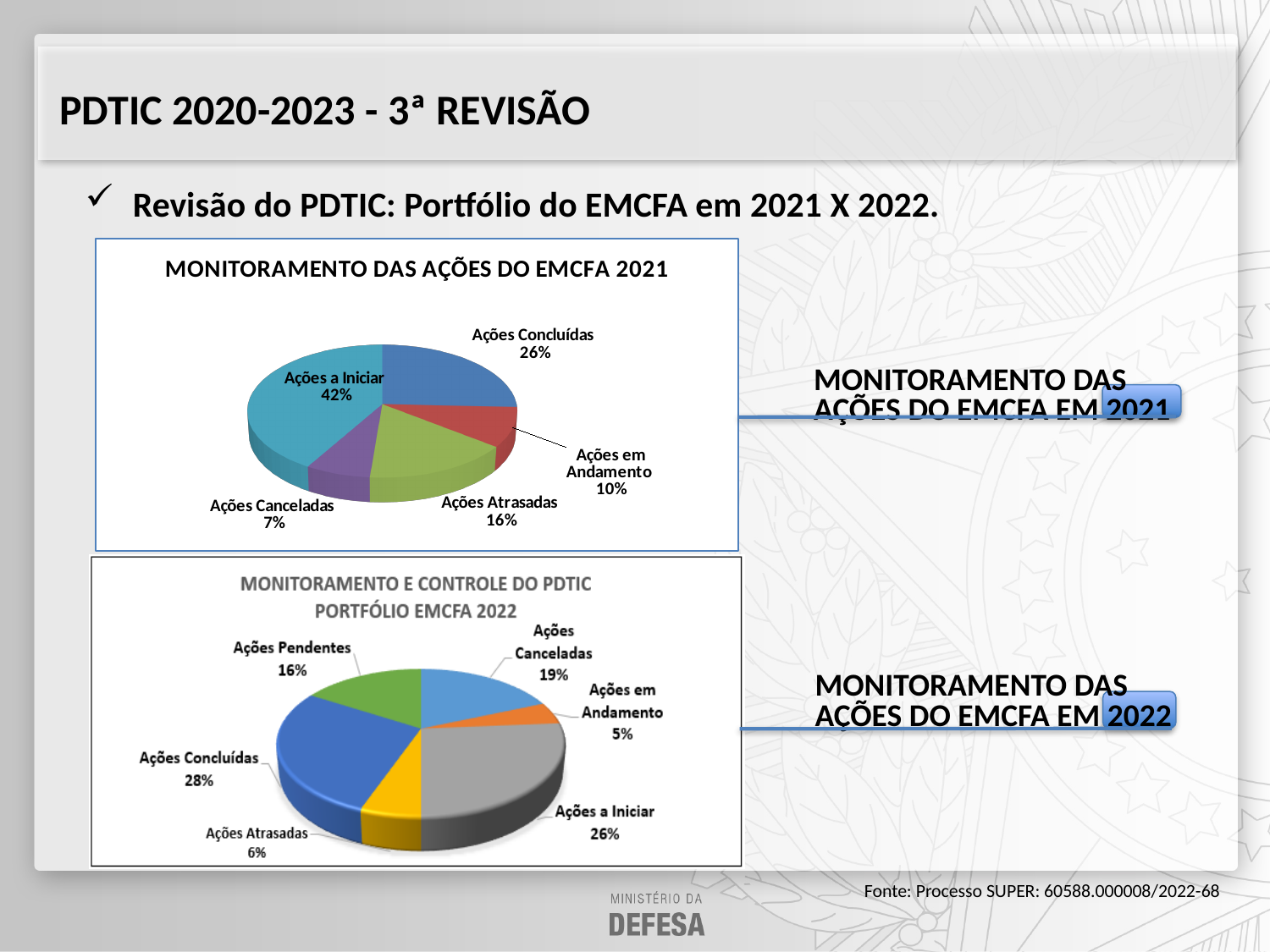
In the 2021 chart, what share is Ações em Andamento? 10% In the 2022 chart (MONITORAMENTO E CONTROLE DO PDTIC PORTFÓLIO EMCFA 2022), what share is Ações Concluídas? 28% In the 2022 chart, how many categories does the pie have? 6 In the 2021 chart, which category has the largest share? Ações a Iniciar What type of chart is the 2022 chart? Pie chart In the 2021 chart, how many categories does the pie have? 5 In the 2022 chart, what share is Ações Canceladas? 19% In the 2022 chart, which category has the smallest share? Ações em Andamento In the 2021 chart, what is the difference between Ações Concluídas and Ações Atrasadas? 10% In the 2022 chart, which is larger, Ações Pendentes or Ações Atrasadas? Ações Pendentes In the 2021 chart, which category has the smallest share? Ações Canceladas